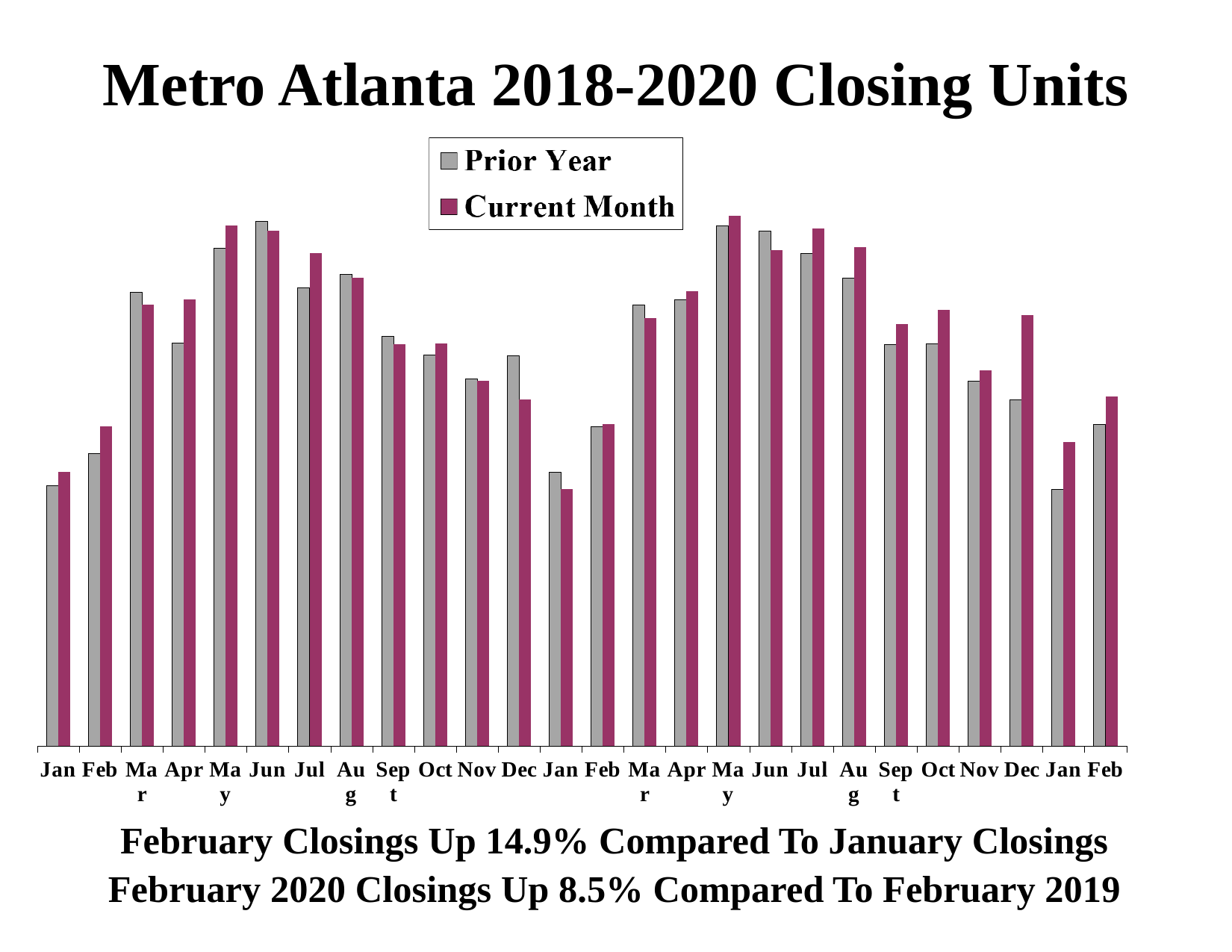
How many month categories are shown along the x axis? 26 How many series does the legend list? 2 For the last Jan on the x axis, which is larger: the Prior Year bar or the Current Month bar? Current Month What kind of chart is shown on the slide? bar chart For the second Dec on the x axis, which is larger: the Prior Year bar or the Current Month bar? Current Month Which of the two Jan categories in the middle of the chart has the larger Prior Year bar: the first Jan or the second Jan? the second Jan Do the Current Month bars rise or fall from the first Jan to the first Jun on the x axis? rise Do the Current Month bars rise or fall from the first Jun to the first Dec on the x axis? fall What are the two series named in the legend? Prior Year and Current Month What is the title of the chart? Metro Atlanta 2018-2020 Closing Units